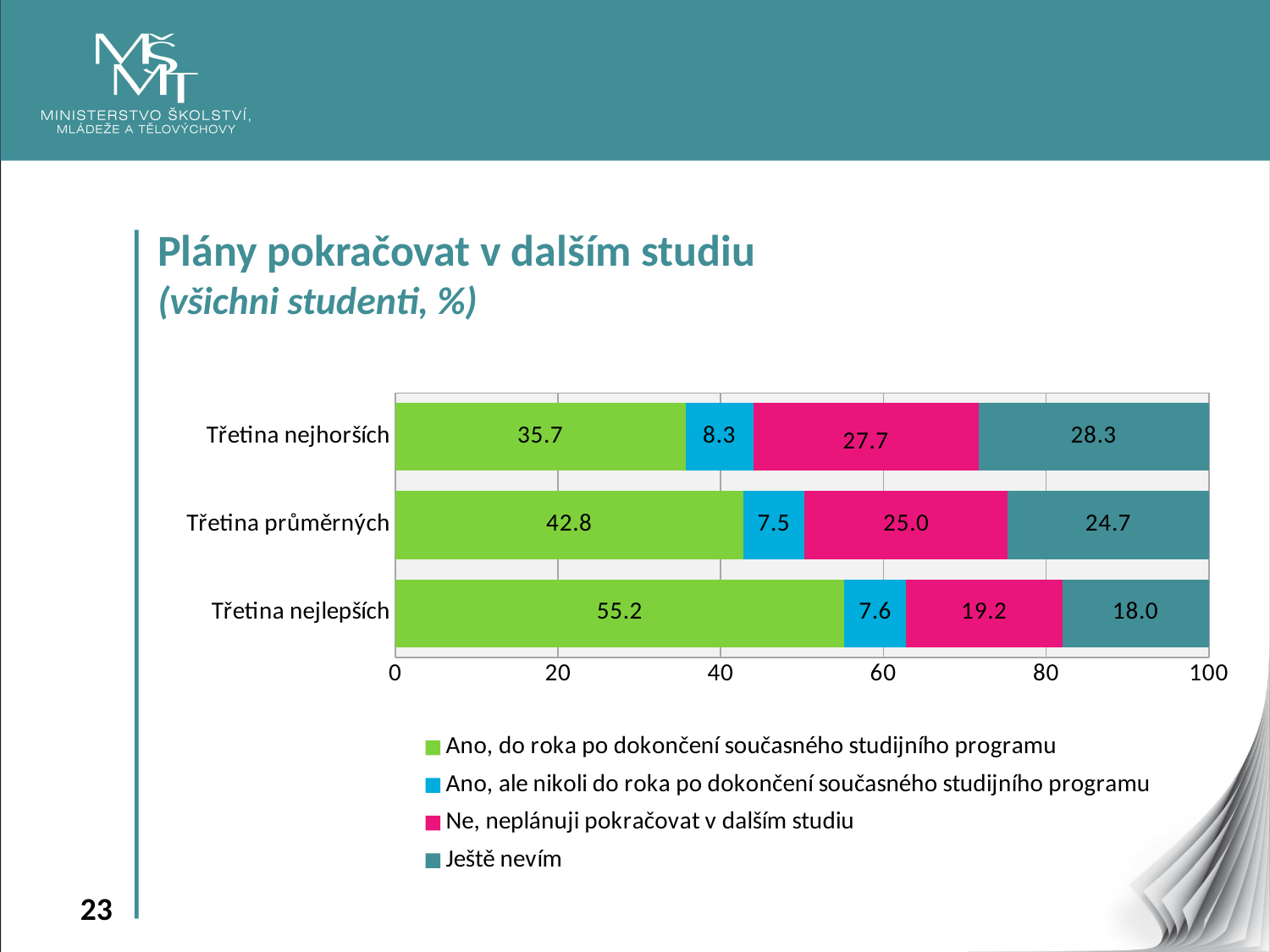
Which category has the highest value for "Ano, do roka po dokončení současného studijního programu"? Třetina nejlepších What kind of chart is shown on the slide? Stacked bar chart Which category has the lowest value for "Ještě nevím"? Třetina nejlepších Which is larger: the "Ne, neplánuji pokračovat v dalším studiu" value for Třetina nejhorších or for Třetina nejlepších? Třetina nejhorších What is the value of "Ne, neplánuji pokračovat v dalším studiu" for Třetina průměrných? 25.0 What is the difference between the "Ano, do roka po dokončení současného studijního programu" values for Třetina nejlepších and Třetina nejhorších? 19.5 What is the total of the stacked bar for Třetina průměrných? 100.0 What is the value of "Ano, ale nikoli do roka po dokončení současného studijního programu" for Třetina nejhorších? 8.3 What is the value of "Ano, do roka po dokončení současného studijního programu" for Třetina nejlepších? 55.2 How many series does the legend list? 4 How many categories are shown on the y axis of the chart? 3 What is the value of "Ještě nevím" for Třetina nejhorších? 28.3